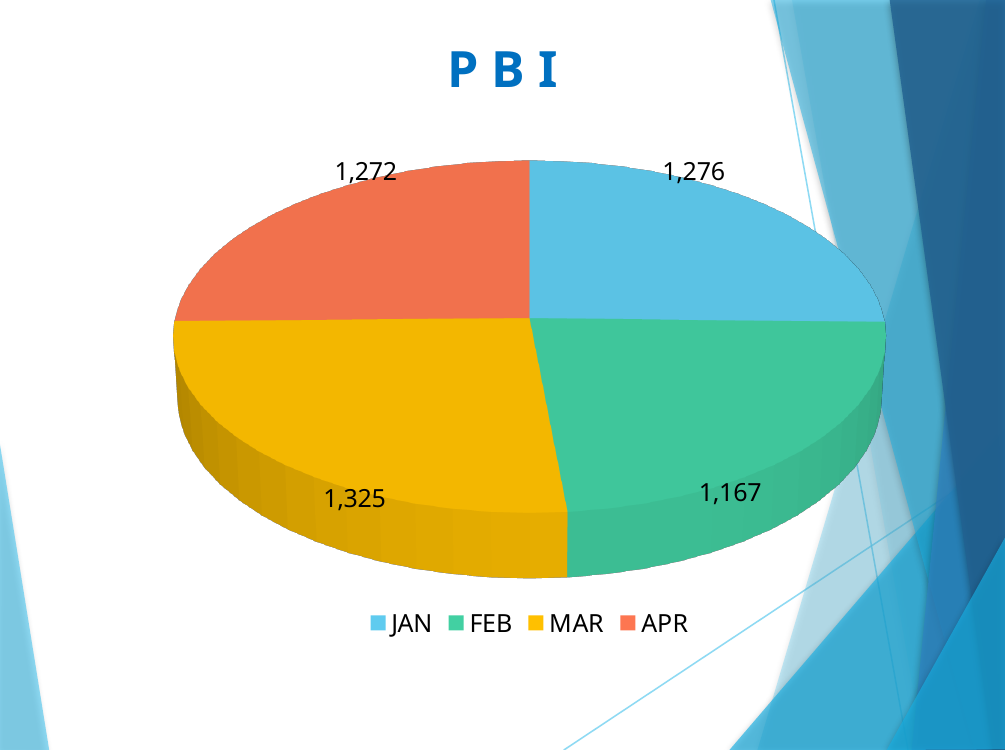
How many slices does the pie chart have? 4 Which month has the largest slice? MAR What is the value for FEB? 1,167 Which colour represents APR in the legend? Orange What is the value for MAR? 1,325 Which is larger, the value for MAR or the value for FEB? MAR Which month has the smallest slice? FEB What type of chart is shown on the slide? Pie chart What is the title of the chart? P B I What is the value for APR? 1,272 What is the value for JAN? 1,276 What is the difference between the values for MAR and FEB? 158